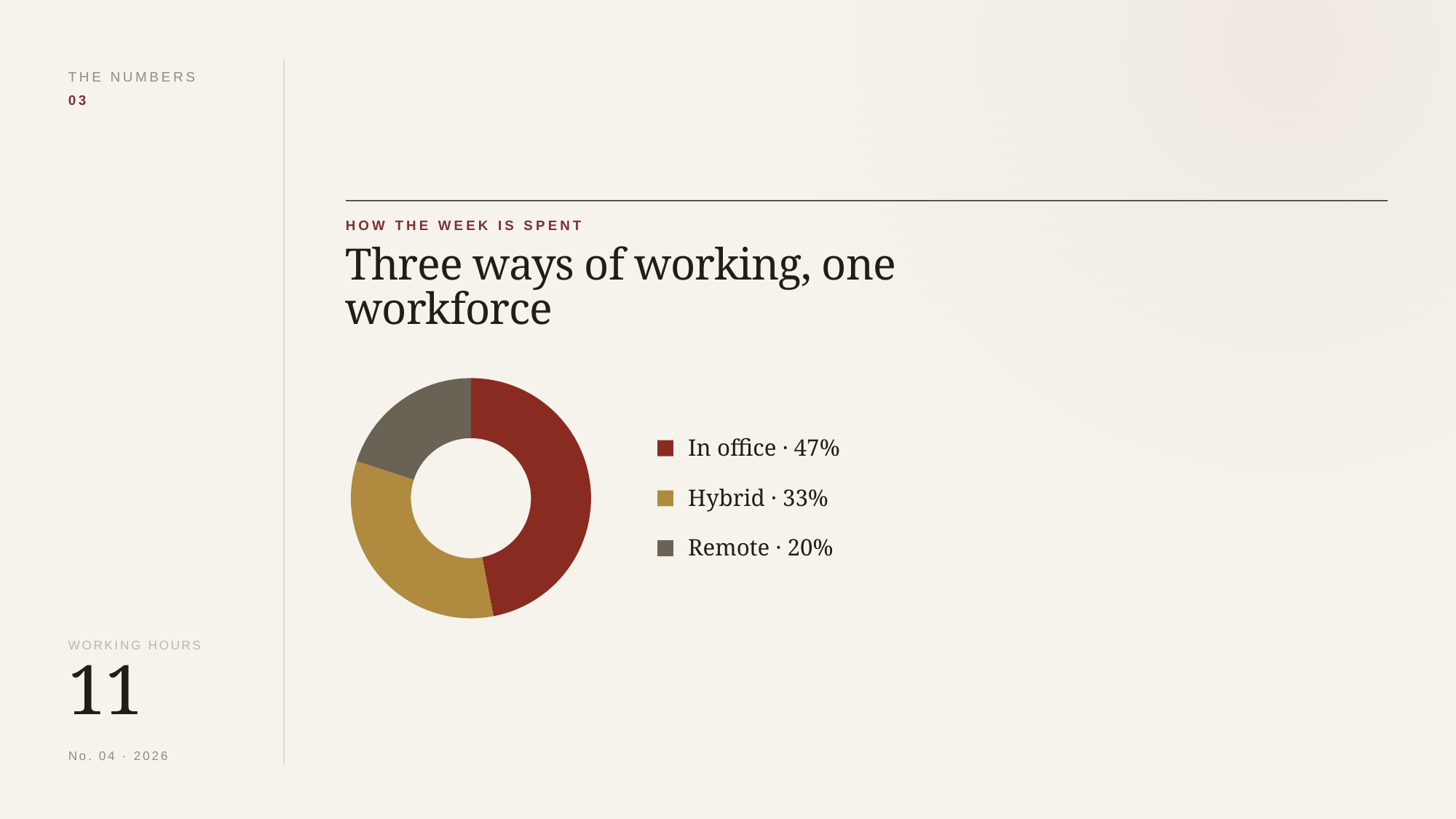
What is the difference in percentage points between Hybrid and Remote? 13 What colour represents the Hybrid category? Gold What kind of chart is shown on the slide? Doughnut chart What is the difference in percentage points between In office and Hybrid? 14 What share of the workforce is In office? 47% What share of the workforce is Hybrid? 33% Which way of working has the smallest share? Remote Which way of working has the largest share? In office What share of the workforce is Remote? 20% What is the heading above the chart? Three ways of working, one workforce Which is larger, the Hybrid share or the Remote share? Hybrid How many categories does the chart show? 3